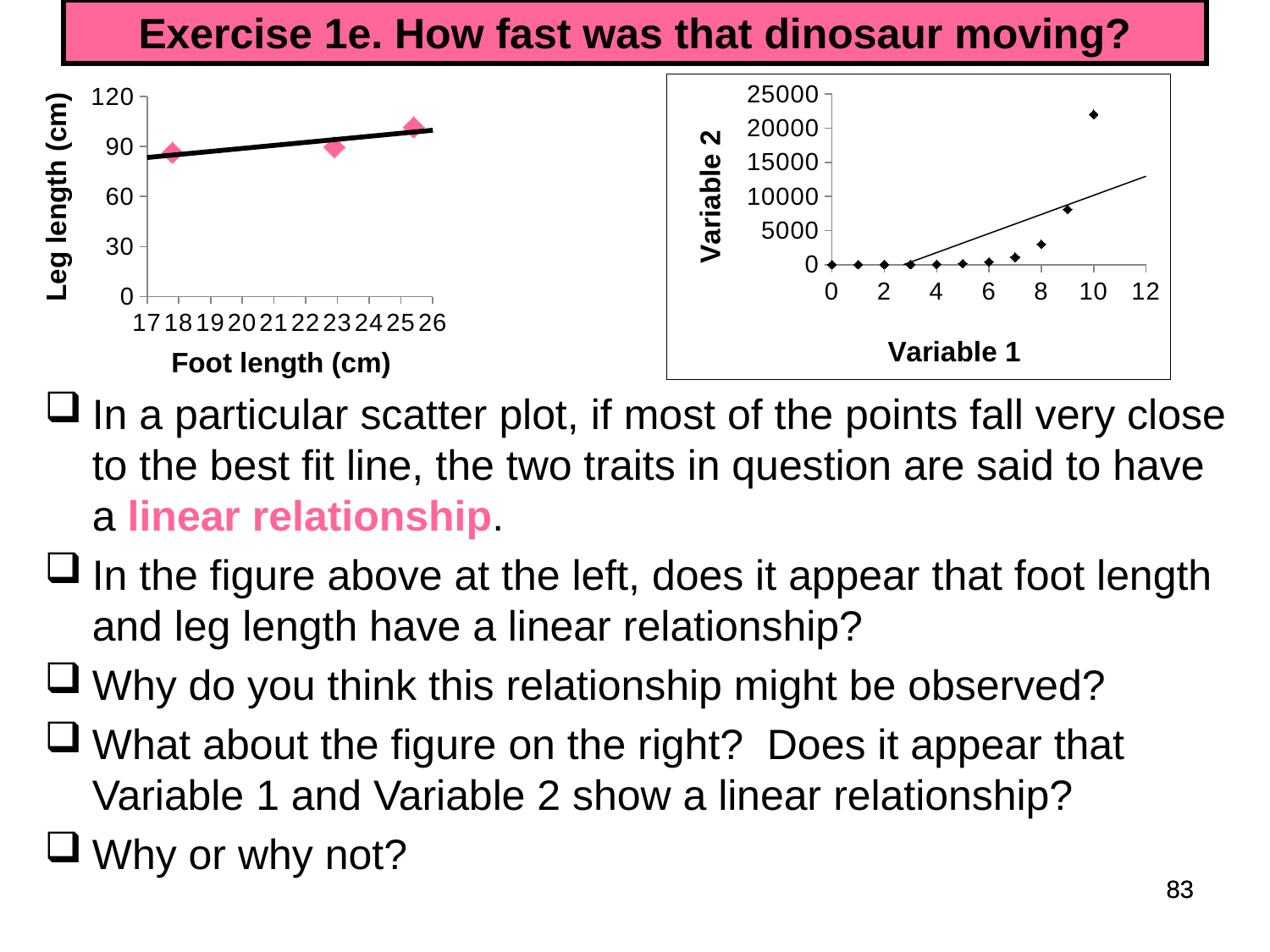
What kind of chart is the chart on the right (Variable 1 vs Variable 2)? scatter plot On the chart on the right, is the Variable 2 value at Variable 1 = 8 greater or less than 5000? less On the chart on the right, which has the larger Variable 2 value: Variable 1 = 9 or Variable 1 = 10? Variable 1 = 10 On the chart on the right, is the Variable 2 value at Variable 1 = 10 greater or less than 20000? greater On the chart on the right, do the Variable 2 values rise or fall as Variable 1 increases? rise On the chart on the left, do the leg length values generally rise or fall as foot length increases? rise How many data points are plotted on the chart on the right (Variable 1 vs Variable 2)? 11 On the chart on the left, what is the label of the y axis? Leg length (cm) On the chart on the right, at which Variable 1 value is Variable 2 highest? 10 What kind of chart is the chart on the left (Foot length vs Leg length)? scatter plot On the chart on the right, what is the label of the x axis? Variable 1 How many data points are plotted on the chart on the left (Foot length vs Leg length)? 3